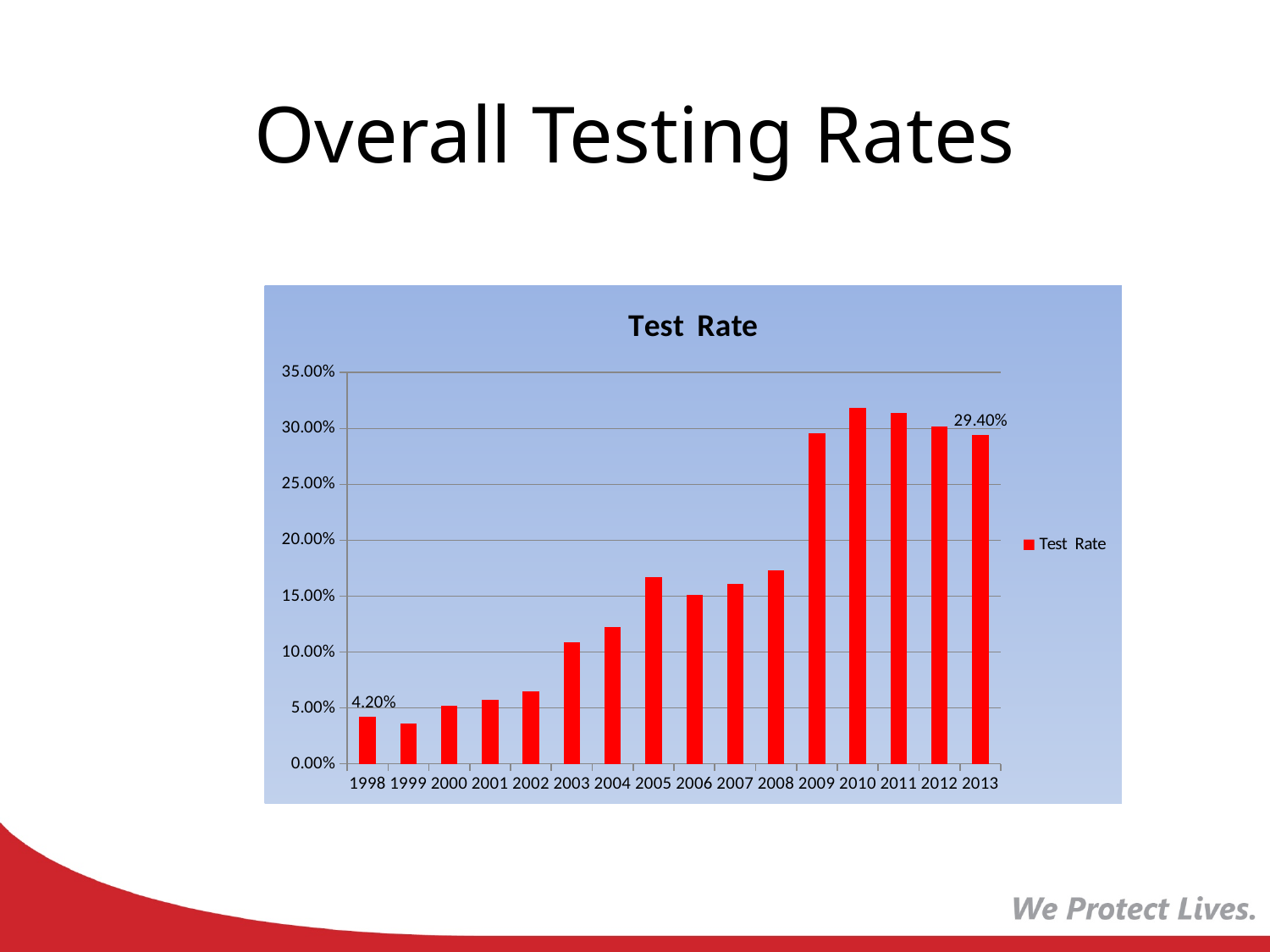
Is the value for 2009 greater or less than 25.00%? greater What is the value for 2013 in the Test Rate chart? 29.40% What is the value for 1998 in the Test Rate chart? 4.20% How many years are shown on the x axis of the chart? 16 Which is larger, the value for 2003 or the value for 2004? 2004 Which year has the lowest test rate? 1999 What is the difference between the 2013 value and the 1998 value? 25.20% Which is larger, the value for 2008 or the value for 2009? 2009 What kind of chart is shown on the slide? Bar chart Do the test rates generally rise or fall from 1998 to 2010? Rise Is the value for 2008 greater or less than 20.00%? less Is the value for 2003 greater or less than 10.00%? greater